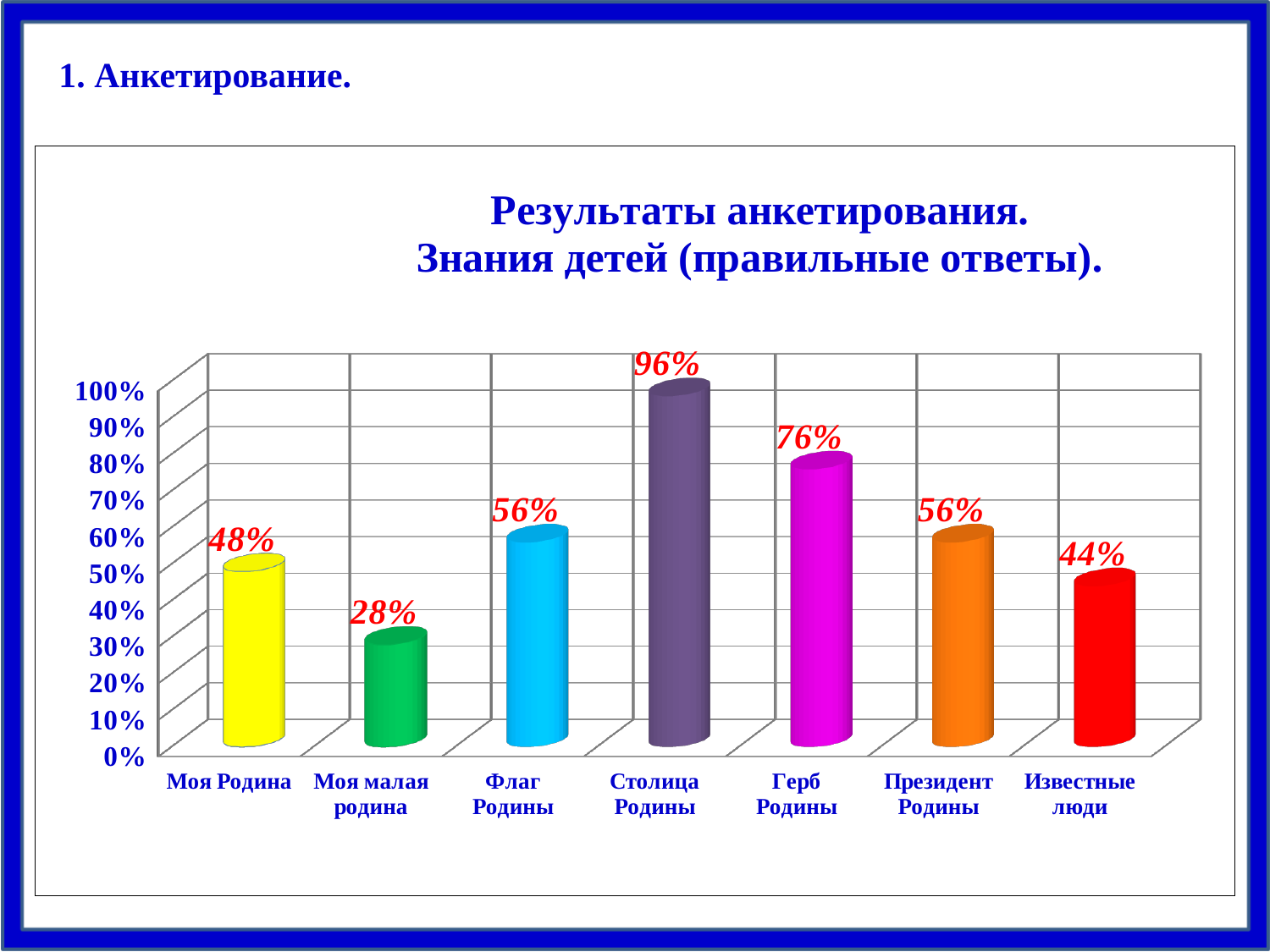
Which category has the highest value? Столица Родины What is the value for Известные люди? 44% What is the difference between the values for Столица Родины and Герб Родины? 20% What is the value for Моя малая родина? 28% What is the value for Столица Родины? 96% What is the difference between the values for Моя Родина and Моя малая родина? 20% What kind of chart is shown on the slide? bar chart Is the value for Моя Родина greater or less than 50%? less Which is larger, the value for Герб Родины or the value for Президент Родины? Герб Родины How many categories are shown on the x axis? 7 Which category has the lowest value? Моя малая родина What is the title of the chart? Результаты анкетирования. Знания детей (правильные ответы).